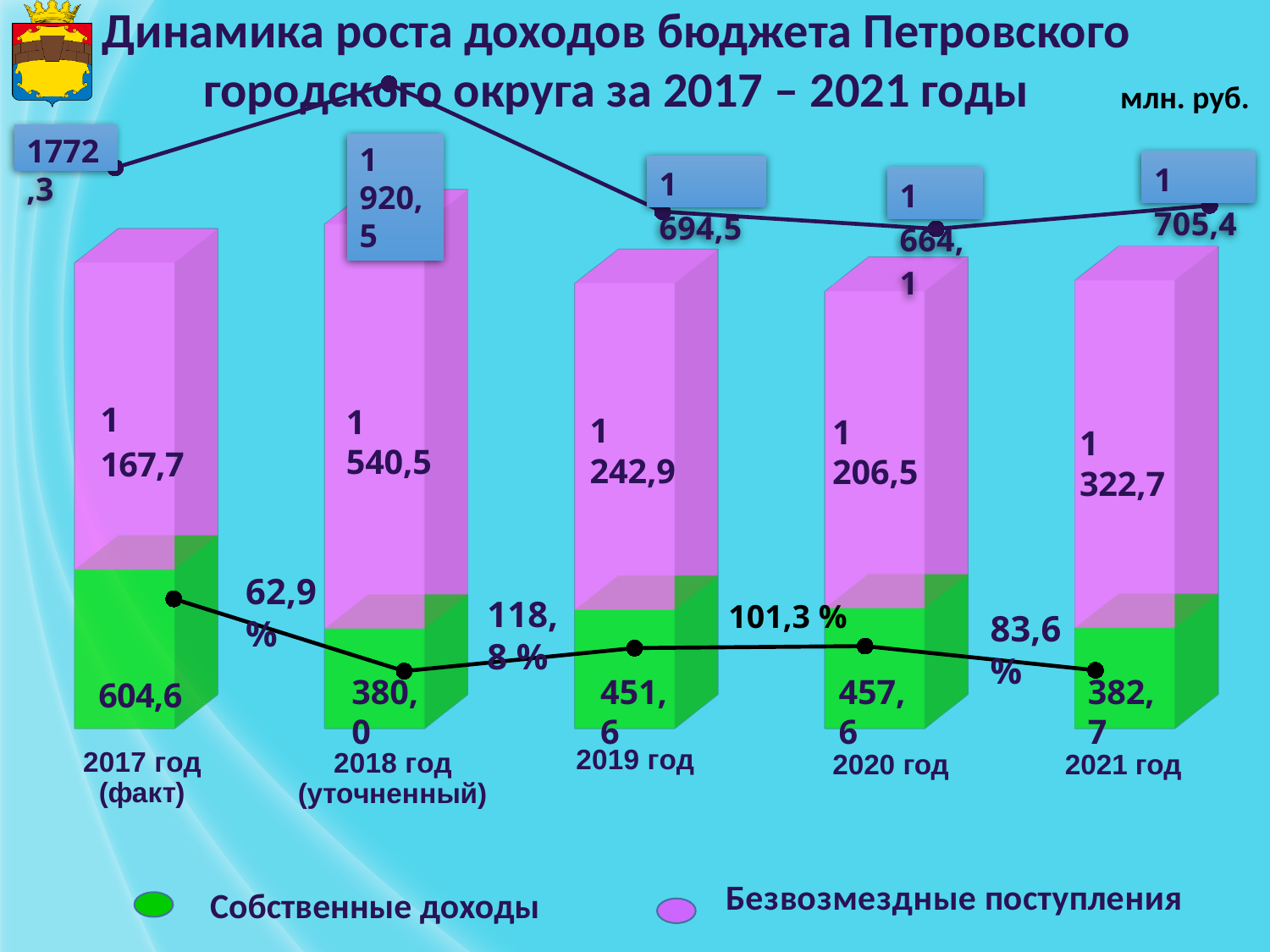
How many years (categories) are shown on the chart? 5 What is the total of the stacked bar for 2019 год, as labelled on the slide? 1 694,5 What is the value of Собственные доходы for 2020 год? 457,6 Which year has the lowest value of Собственные доходы? 2018 год (уточненный) What is the value of Собственные доходы for 2017 год (факт)? 604,6 How many series does the legend list? 2 What is the value of Безвозмездные поступления for 2018 год (уточненный)? 1 540,5 Is the value of Безвозмездные поступления larger for 2019 год or for 2020 год? 2019 год Which year has the highest value of Безвозмездные поступления? 2018 год (уточненный) What kind of chart is shown on the slide? Stacked bar chart Which year has the highest value of Собственные доходы? 2017 год (факт) What is the value of Безвозмездные поступления for 2021 год? 1 322,7